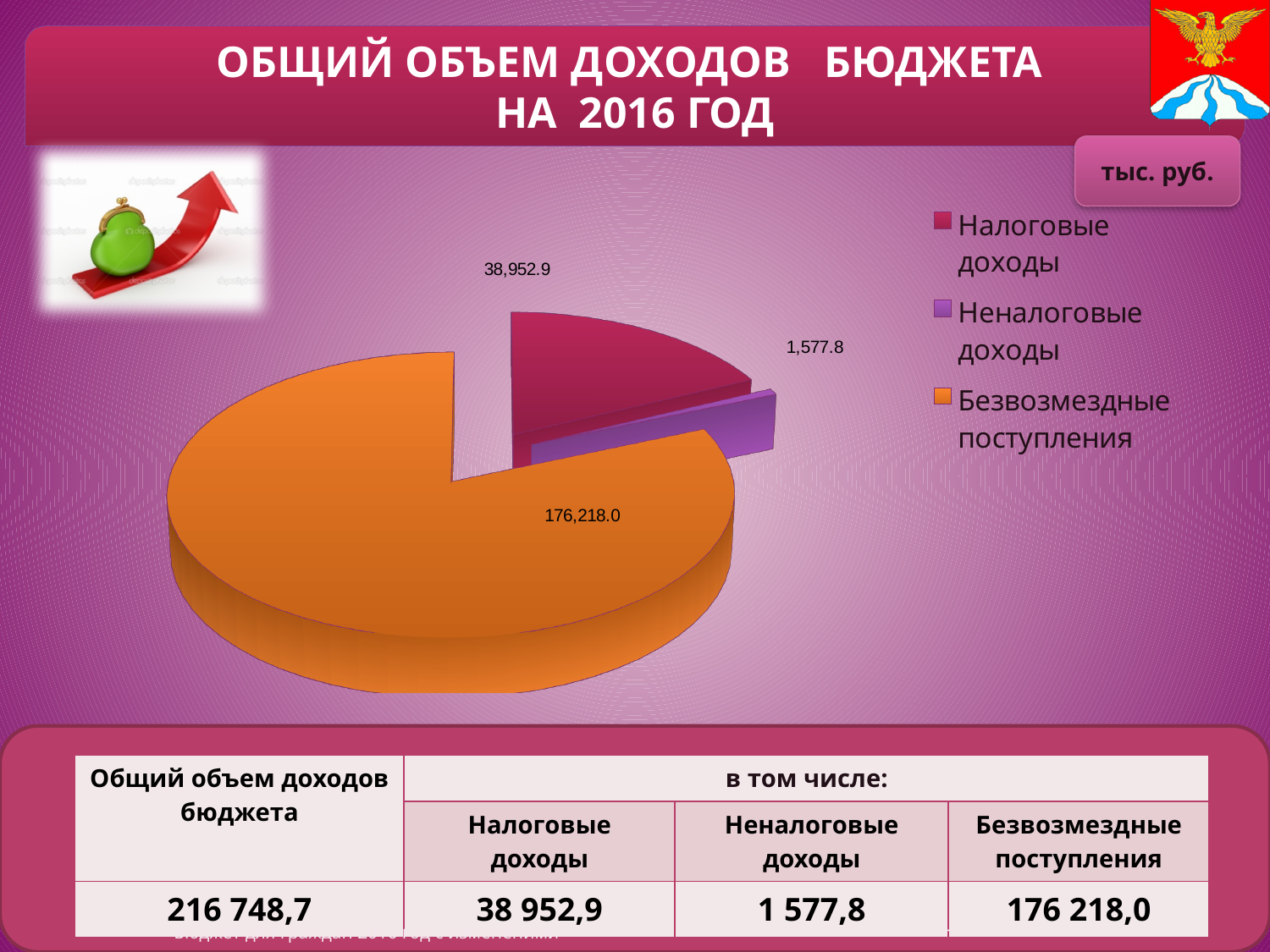
How many slices does the pie chart have? 3 Which category has the smallest slice in the pie chart? Неналоговые доходы Which is larger in the pie chart: Налоговые доходы or Неналоговые доходы? Налоговые доходы Which category has the largest slice in the pie chart? Безвозмездные поступления How many entries does the legend of the pie chart list? 3 What kind of chart is shown on the slide? pie chart What unit is indicated for the values in the pie chart? тыс. руб. What is the value for Безвозмездные поступления in the pie chart? 176,218.0 What is the value for Неналоговые доходы in the pie chart? 1,577.8 What is the value for Налоговые доходы in the pie chart? 38,952.9 What is the difference between Безвозмездные поступления and Налоговые доходы in the pie chart? 137,265.1 What is the total of all three slices in the pie chart? 216,748.7